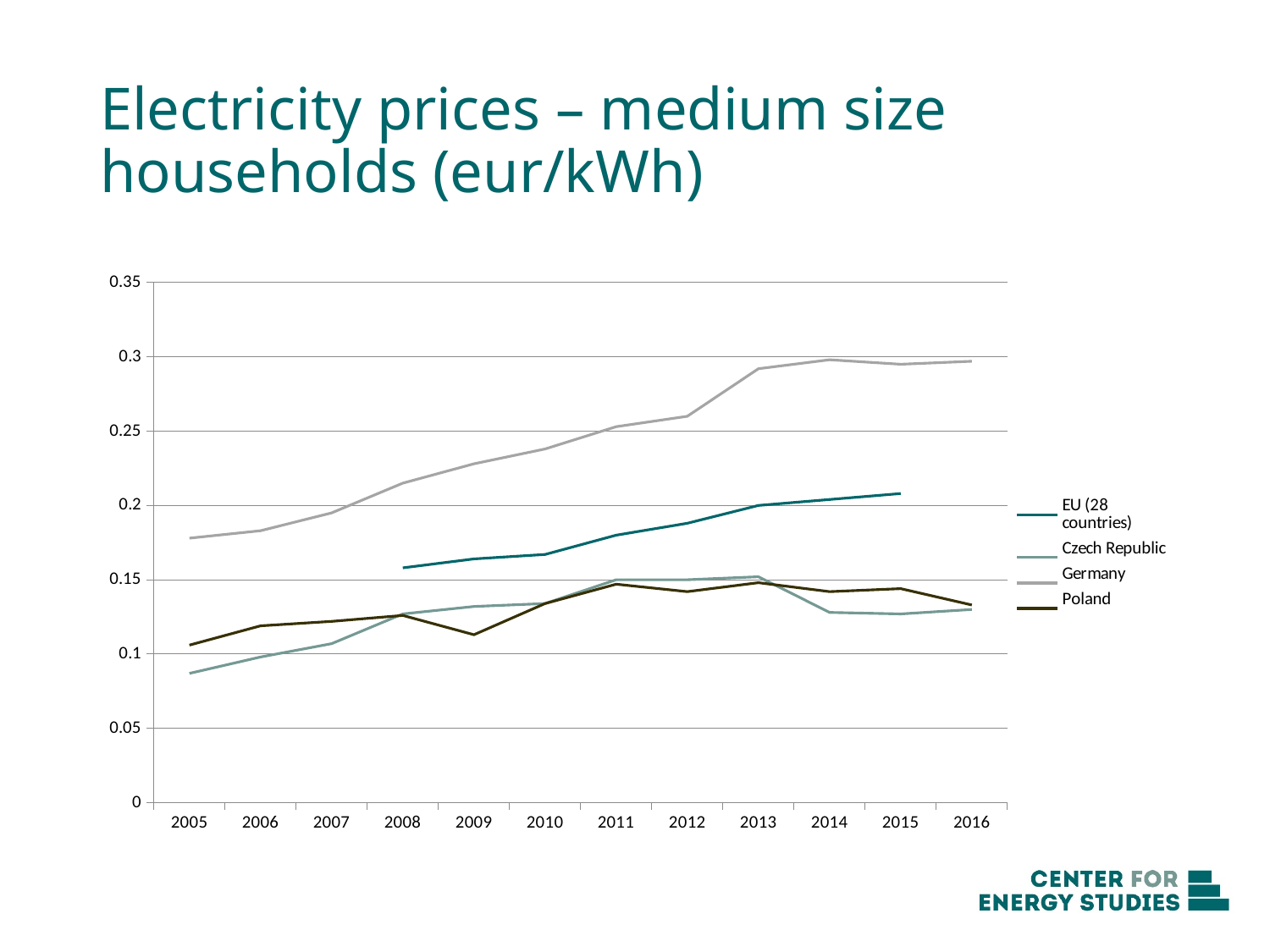
Is the value for EU (28 countries) in 2008 greater or less than 0.2? less Is the value for Germany in 2016 greater or less than 0.25? greater Is the value for Germany in 2005 greater or less than 0.2? less In 2014, which is higher: Poland or Czech Republic? Poland Which series has the highest value in 2016? Germany What is the title of the slide? Electricity prices – medium size households (eur/kWh) How many series does the legend list? 4 Which series has the lowest value in 2005? Czech Republic What kind of chart is shown on the slide? line chart Does the Germany series rise or fall from 2005 to 2016? rise How many years are shown on the x axis? 12